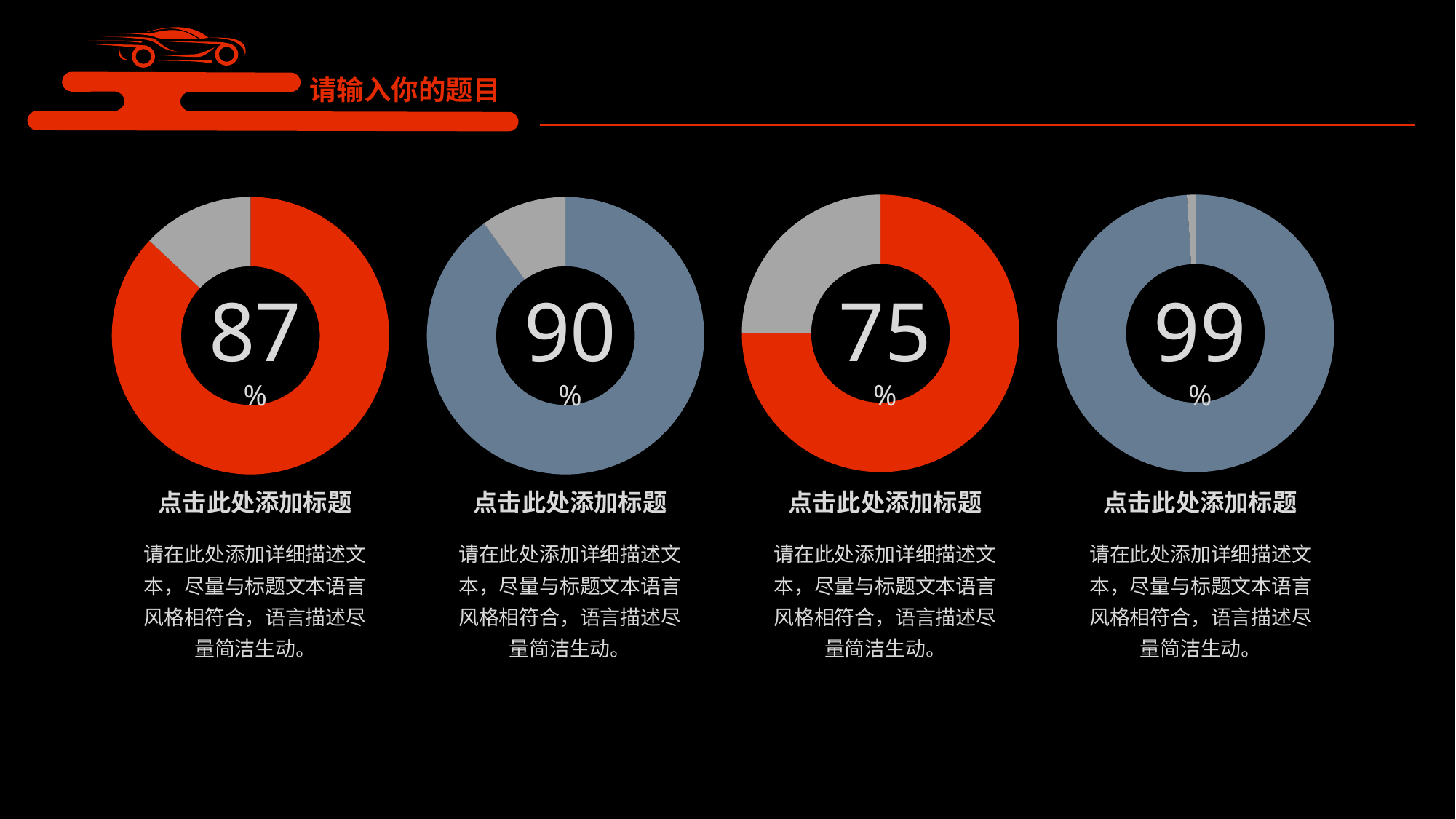
What is the difference between the value in the rightmost donut chart and the value in the leftmost donut chart? 12% Which of the four donut charts shows the highest percentage? The fourth (rightmost) chart, 99% What value is shown in the centre of the fourth (rightmost) donut chart? 99% What kind of chart is used to display the percentages on this slide? Donut chart Which of the four donut charts shows the lowest percentage? The third chart from the left, 75% What value is shown in the centre of the second donut chart from the left? 90% Which is larger: the value in the first donut chart or the value in the second donut chart? The second donut chart (90%) What is the difference between the values of the second and third donut charts from the left? 15% What value is shown in the centre of the third donut chart from the left? 75% What colour is the filled portion of the third donut chart from the left? Red How many donut charts are shown on the slide? 4 What value is shown in the centre of the first (leftmost) donut chart? 87%